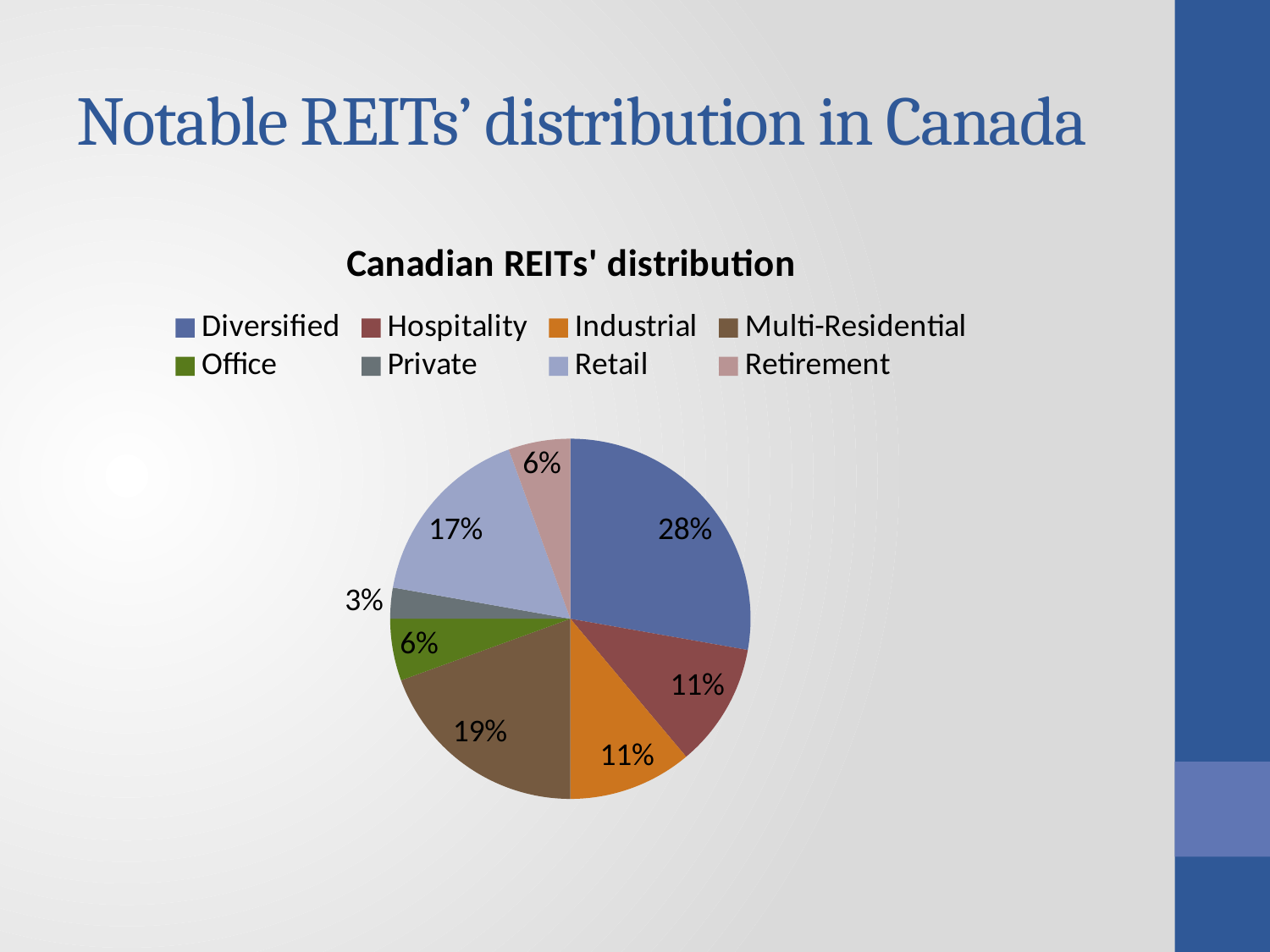
How many categories does the legend list? 8 What is the difference between the Diversified and Retail shares? 11% What is the value for Private? 3% Which category has the largest slice of the pie? Diversified Which is larger, the Multi-Residential slice or the Retail slice? Multi-Residential What share of the pie does Diversified represent? 28% Which category has the smallest slice of the pie? Private What is the title of the chart? Canadian REITs' distribution What share of the pie does Retail represent? 17% What is the value for Hospitality? 11% What share of the pie does Multi-Residential represent? 19% What type of chart is shown on the slide? Pie chart